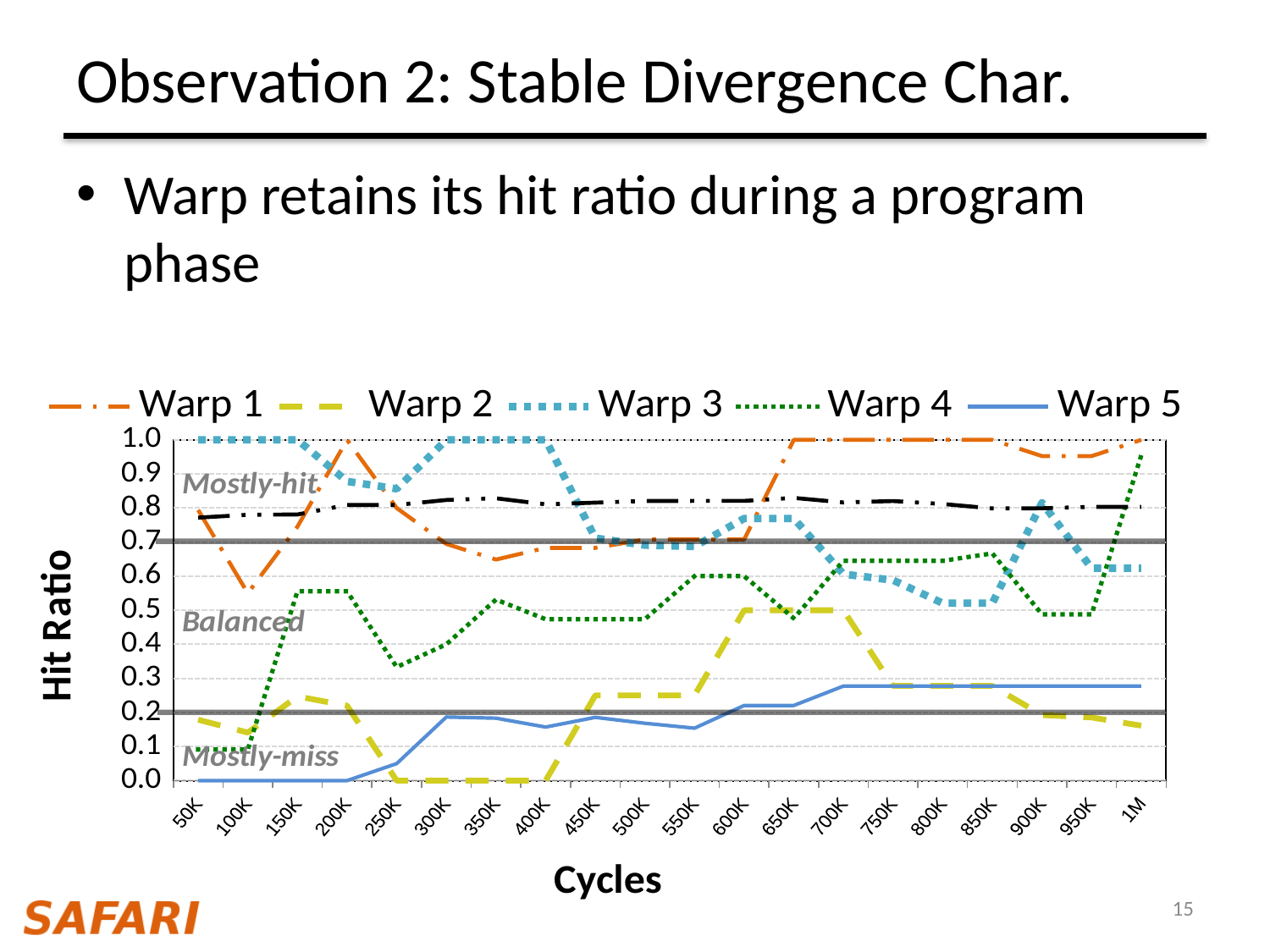
How many cycle points are labelled along the x axis of the chart? 20 What kind of chart is shown on the slide? line chart At 50K cycles, which has the higher hit ratio, Warp 3 or Warp 5? Warp 3 Is the hit ratio for Warp 4 at 250K cycles greater or less than 0.4? less Is the hit ratio for Warp 1 at 700K cycles greater or less than 0.9? greater What is the title of the y axis of the chart? Hit Ratio Which warp has the lowest hit ratio at 1M cycles? Warp 2 Is the hit ratio for Warp 5 at 1M cycles greater or less than 0.2? greater What is the hit ratio of Warp 5 at 50K cycles? 0.0 Does the hit ratio of Warp 2 rise or fall from 600K to 1M cycles? fall How many series does the chart legend list? 5 What is the hit ratio of Warp 3 at 50K cycles? 1.0